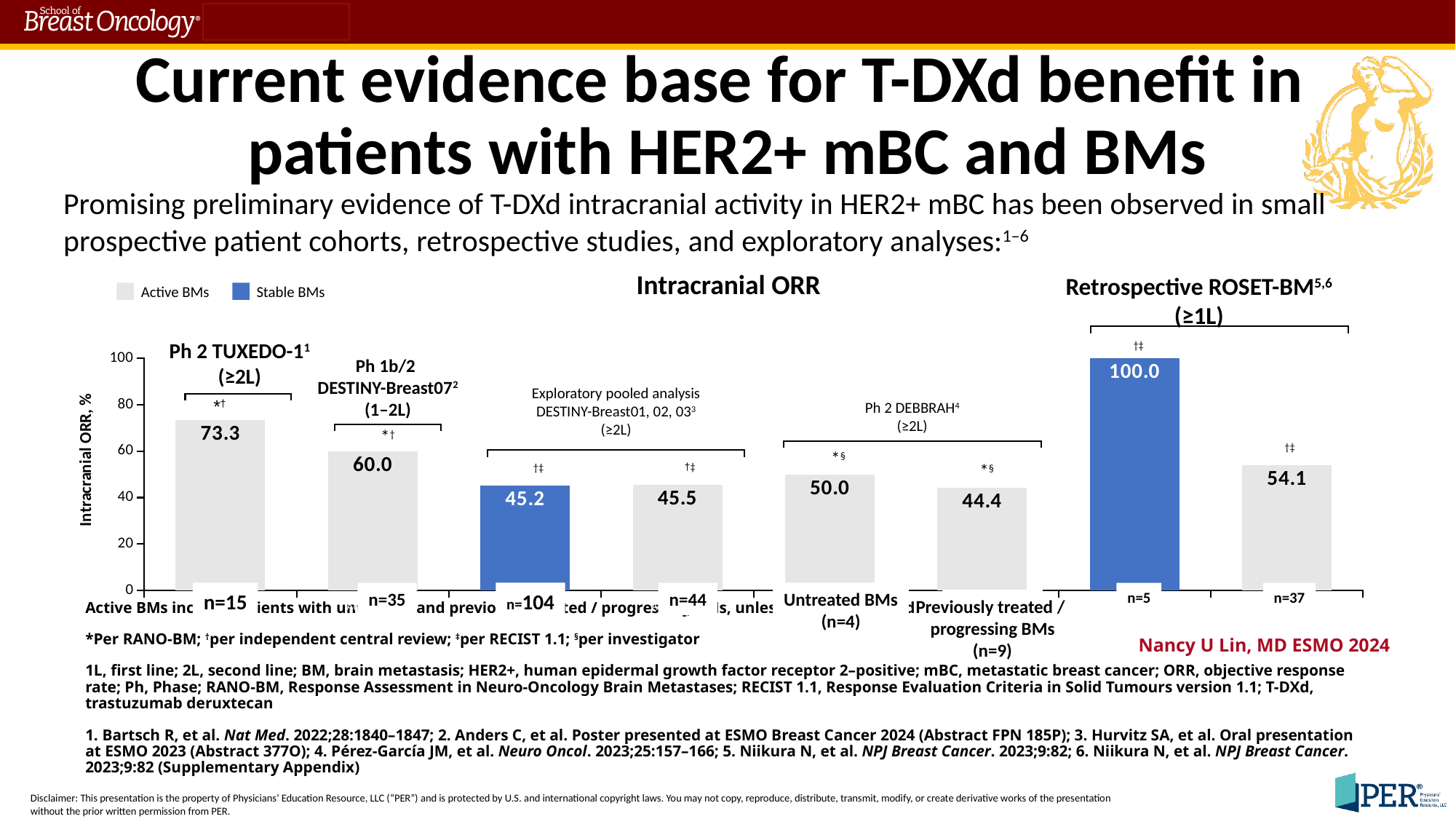
Which colour represents Stable BMs in the legend? Blue What type of chart is used to show intracranial ORR? Bar chart How many bars are plotted on the Intracranial ORR chart? 8 What is the difference in intracranial ORR between the two Retrospective ROSET-BM bars (100.0 and 54.1)? 45.9 In the Ph 2 DEBBRAH study, what is the intracranial ORR for untreated BMs (n=4)? 50.0 Which bar shows the highest intracranial ORR on the chart? Retrospective ROSET-BM, Stable BMs (n=5), 100.0 How many series does the legend list? 2 Which has a higher intracranial ORR: Ph 2 TUXEDO-1 or Ph 1b/2 DESTINY-Breast07? Ph 2 TUXEDO-1 In the Ph 2 DEBBRAH study, what is the intracranial ORR for previously treated / progressing BMs (n=9)? 44.4 Which bar shows the lowest intracranial ORR on the chart? Ph 2 DEBBRAH, previously treated / progressing BMs (n=9), 44.4 What is the intracranial ORR shown for the Ph 2 TUXEDO-1 study? 73.3 What is the intracranial ORR shown for the Ph 1b/2 DESTINY-Breast07 study? 60.0